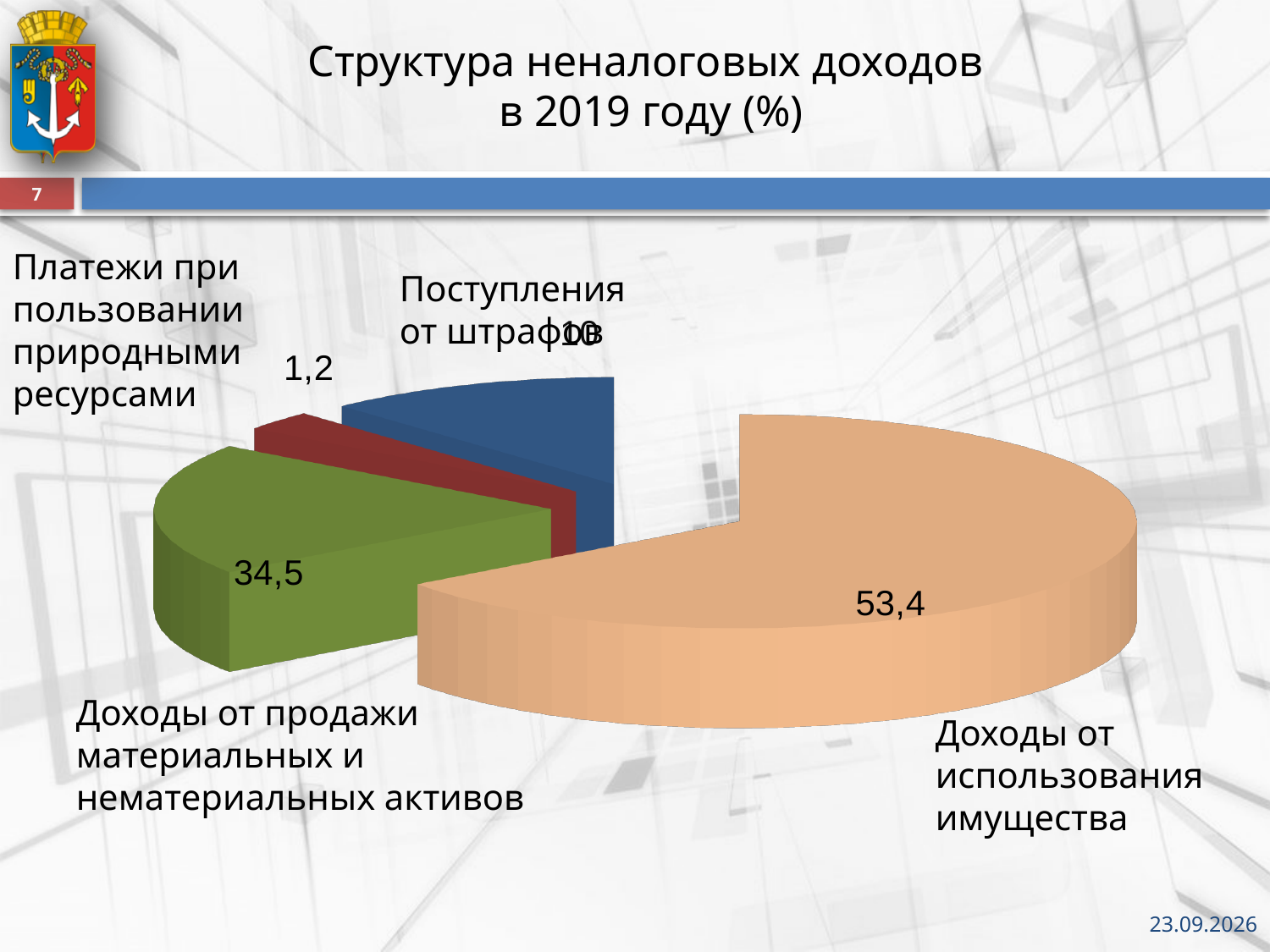
What is the difference between the values for 'Доходы от использования имущества' and 'Доходы от продажи материальных и нематериальных активов'? 18,9 What share does the slice 'Доходы от использования имущества' have in the pie chart? 53,4 What is the title of the chart on the slide? Структура неналоговых доходов в 2019 году (%) How many slices does the pie chart have? 4 What kind of chart is shown on the slide? Pie chart What colour is the slice for 'Доходы от продажи материальных и нематериальных активов'? Green Which category has the largest slice of the pie chart? Доходы от использования имущества What value is shown for 'Доходы от продажи материальных и нематериальных активов'? 34,5 What value is shown for 'Платежи при пользовании природными ресурсами'? 1,2 Which category has the smallest slice of the pie chart? Платежи при пользовании природными ресурсами Which is larger: 'Доходы от использования имущества' or 'Доходы от продажи материальных и нематериальных активов'? Доходы от использования имущества